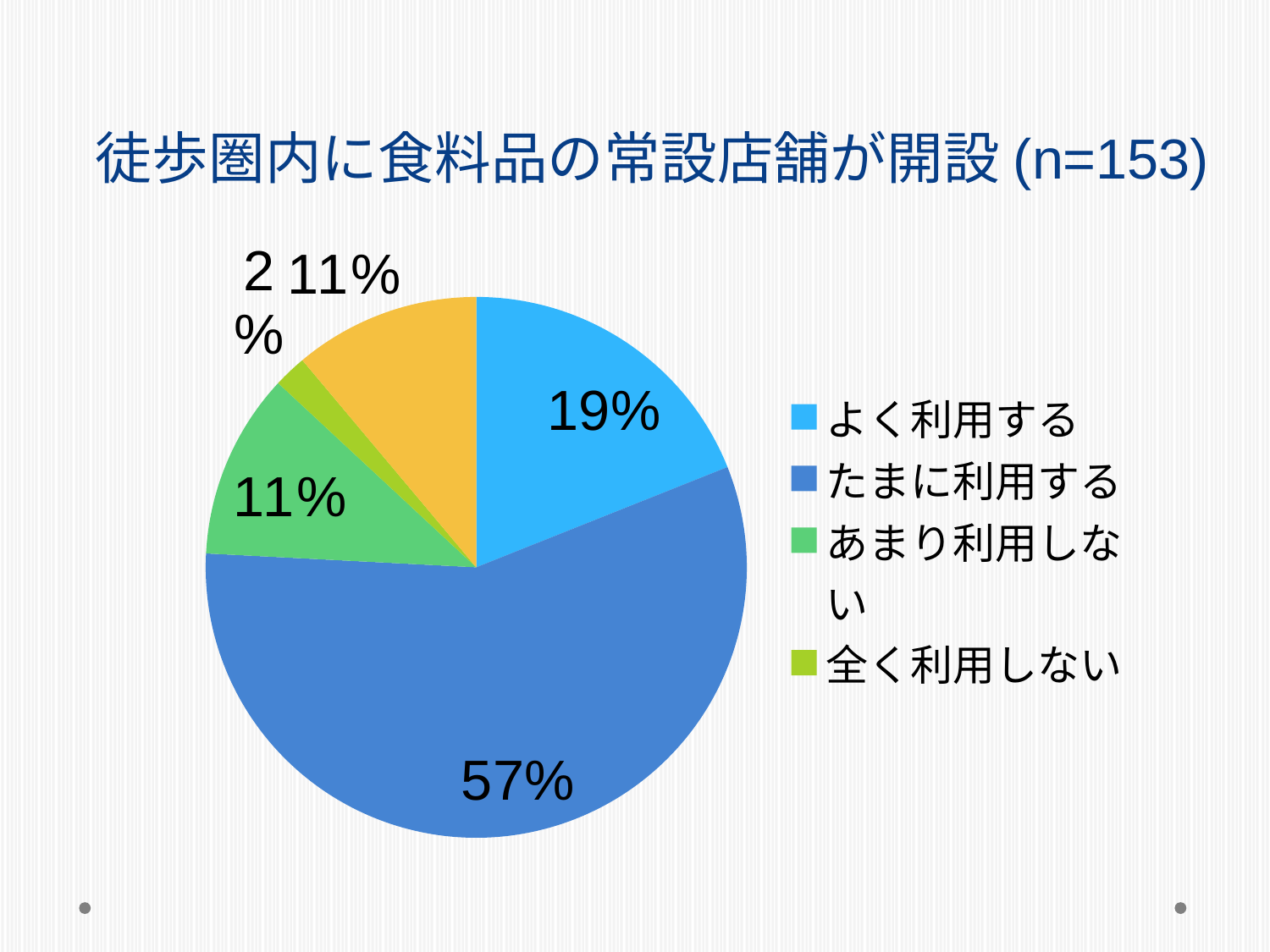
Which category has the largest share of the pie? たまに利用する What colour is the slice for たまに利用する? blue Which is larger, the share for よく利用する or the share for あまり利用しない? よく利用する What percentage of the pie is 全く利用しない? 2% What percentage of the pie is よく利用する? 19% How many entries does the legend list? 4 What percentage of the pie is たまに利用する? 57% What is the title of the chart? 徒歩圏内に食料品の常設店舗が開設 (n=153) What is the difference in percentage points between たまに利用する and よく利用する? 38 What percentage of the pie is あまり利用しない? 11% Which category has the smallest share of the pie? 全く利用しない What kind of chart is shown on the slide? pie chart